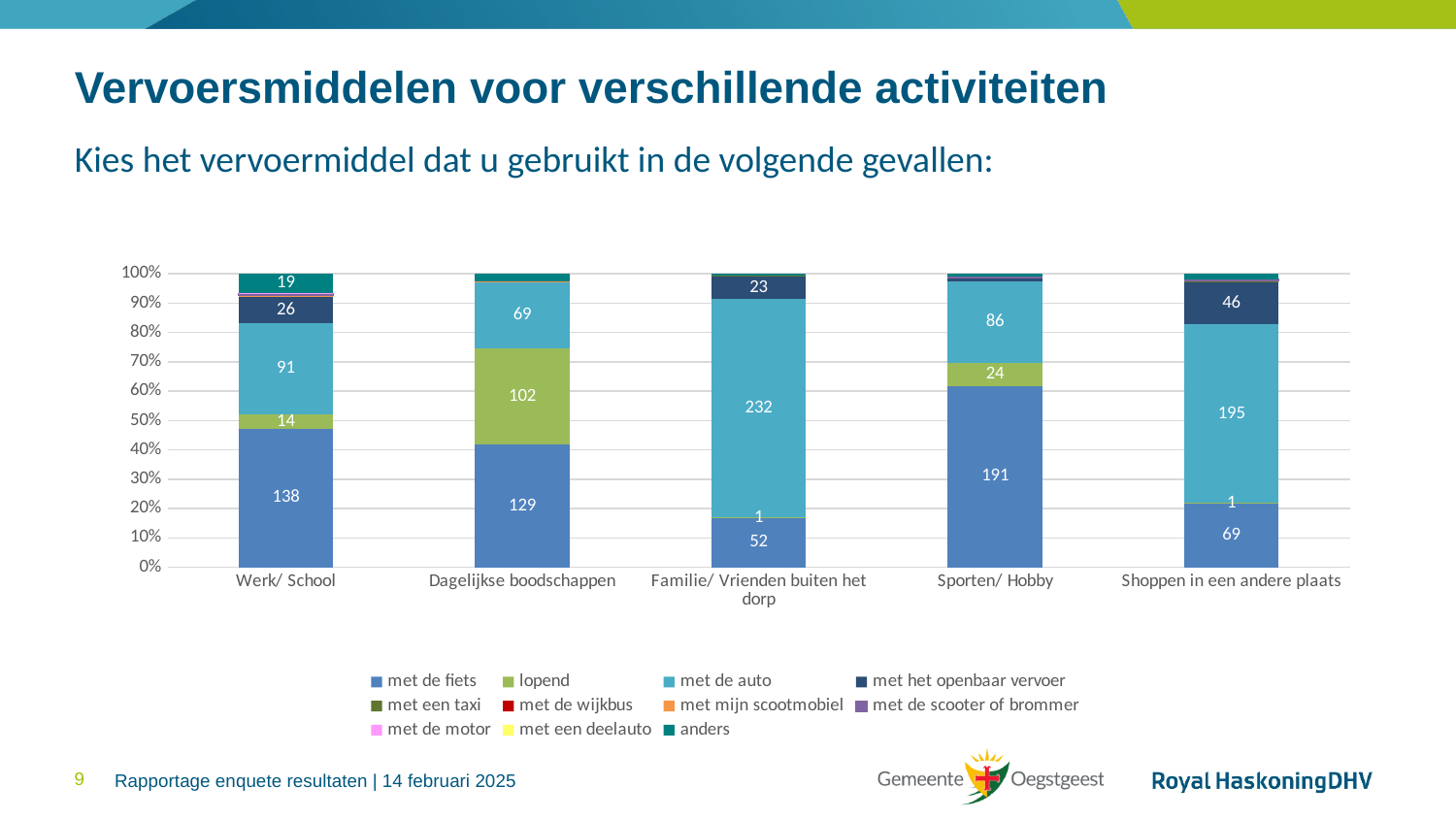
Which is larger: the 'met de fiets' value for 'Werk/ School' or for 'Dagelijkse boodschappen'? Werk/ School What is the value for 'lopend' in the 'Dagelijkse boodschappen' bar? 102 What is the title of the chart slide? Vervoersmiddelen voor verschillende activiteiten What is the value for 'met de auto' in the 'Familie/ Vrienden buiten het dorp' bar? 232 How many series does the legend list? 11 How many activity categories are shown on the x axis? 5 Which category has the highest labelled value for 'met de fiets'? Sporten/ Hobby What is the difference between the 'met de auto' values for 'Shoppen in een andere plaats' and 'Werk/ School'? 104 What is the value for 'met het openbaar vervoer' in the 'Shoppen in een andere plaats' bar? 46 What kind of chart is shown on the slide? stacked bar chart Which category has the highest labelled value for 'met de auto'? Familie/ Vrienden buiten het dorp What is the value for 'met de fiets' in the 'Werk/ School' bar? 138